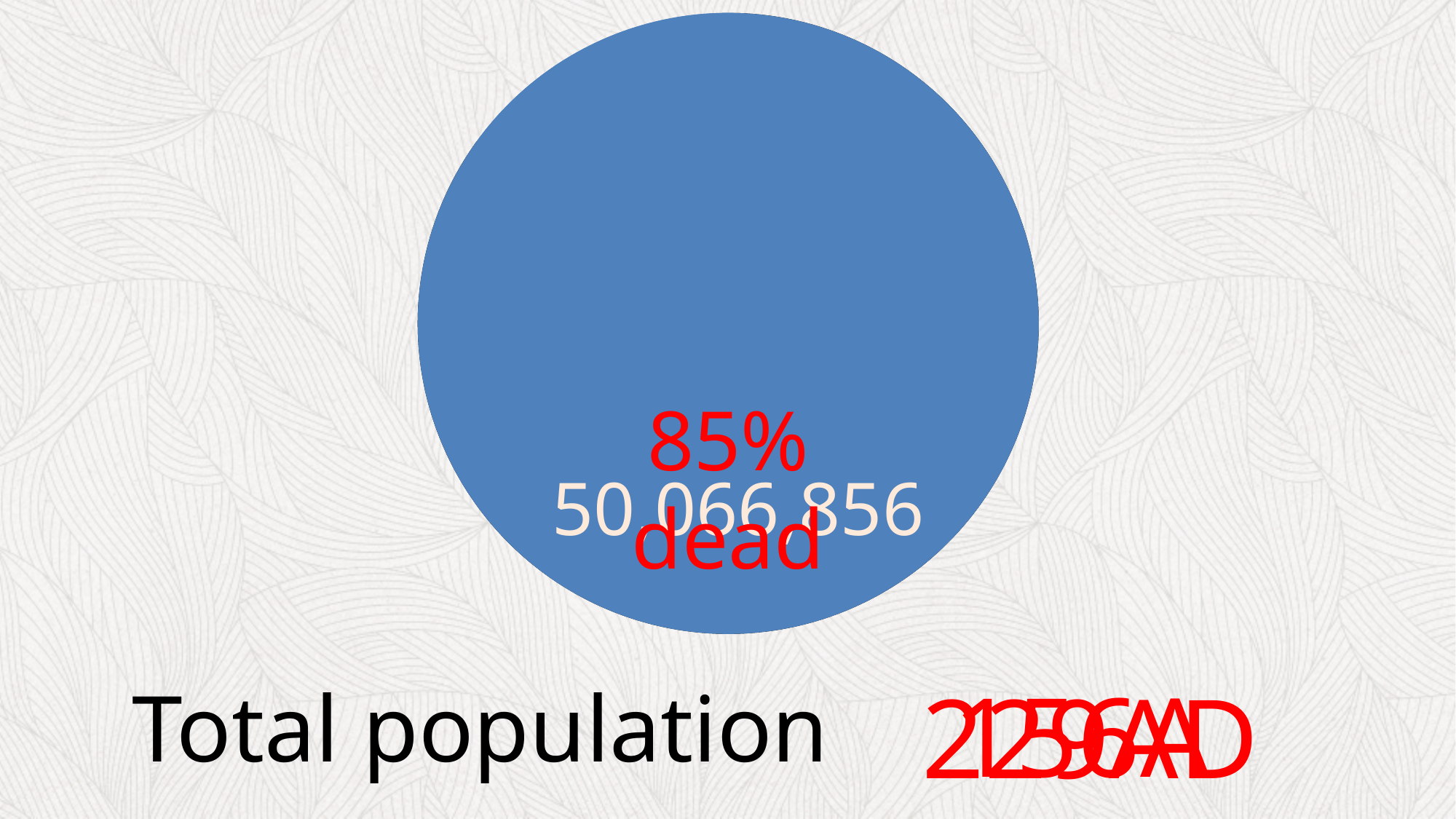
What text appears in black below the pie chart? Total population What value is printed as the data label on the pie chart? 50,066,856 How many slices does the pie chart have? 1 What colour is the pie chart's slice? blue What kind of chart is shown on the slide? pie chart